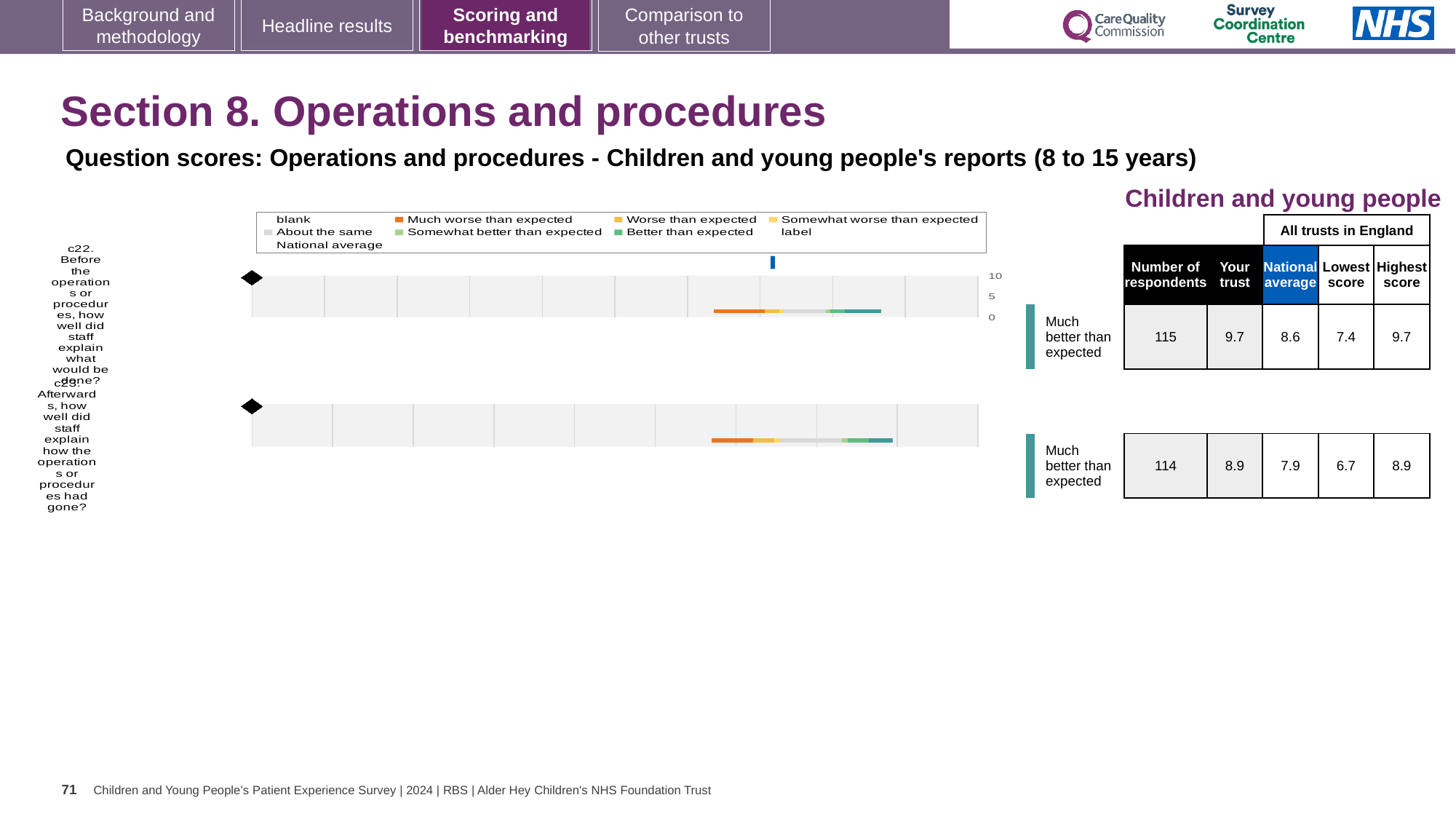
Which question has the higher 'Your trust' score, c22 or c23? c22 What is the difference between the highest score and the lowest score for question c23? 2.2 What is the national average score for question c23? 7.9 What is the national average score for question c22? 8.6 By how much does the trust's score for c22 exceed the national average for c22? 1.1 What benchmark category is the trust's score for c22 placed in? Much better than expected What kind of chart is used to show the question scores for c22 and c23? bar chart How many respondents answered question c22? 115 What colour represents 'Much worse than expected' in the chart legend? orange What is the 'Your trust' score for question c23 (Afterwards, how well did staff explain how the operations or procedures had gone?)? 8.9 How many survey questions are plotted on the slide? 2 What is the 'Your trust' score for question c22 (Before the operations or procedures, how well did staff explain what would be done?)? 9.7